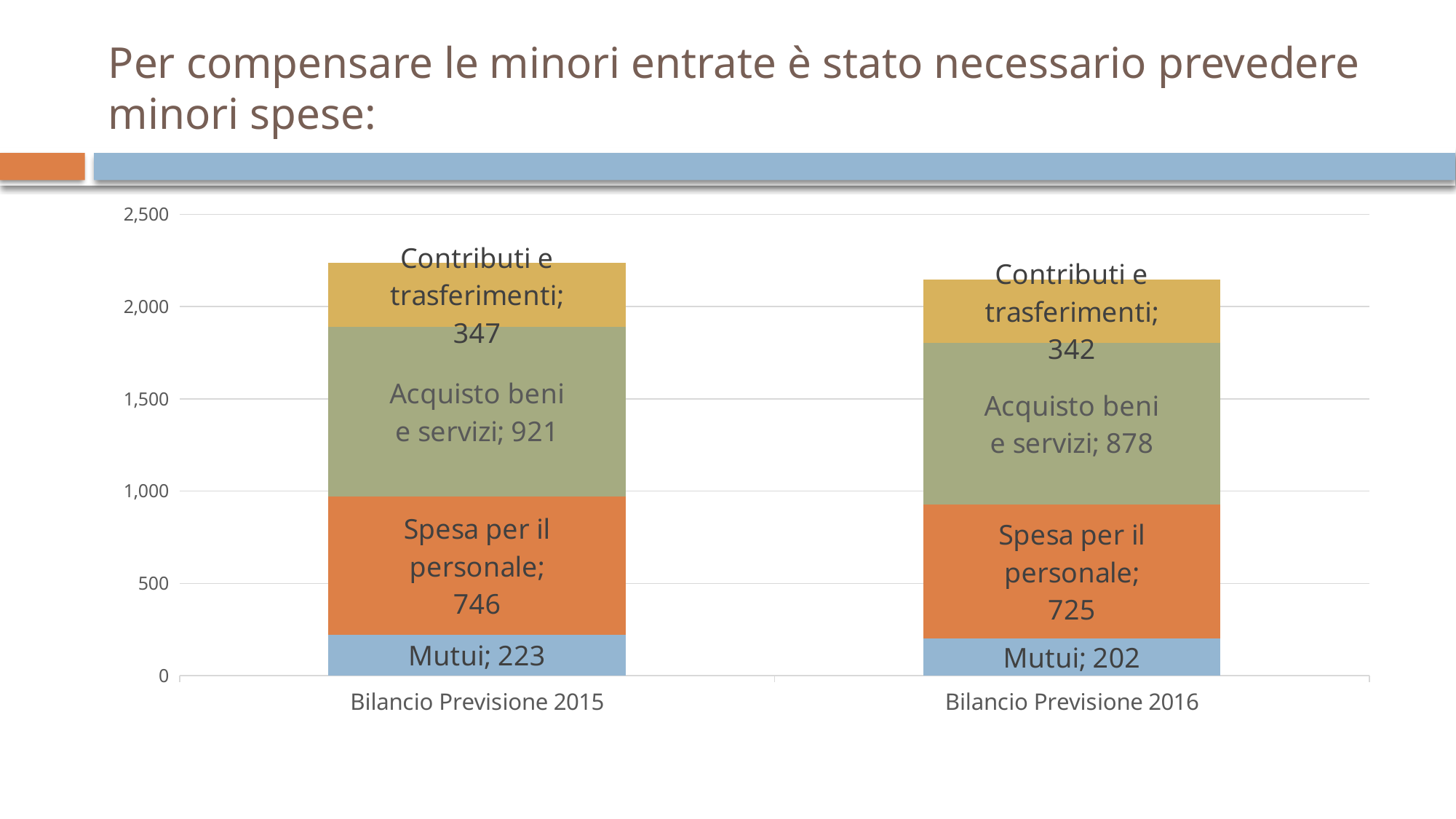
What kind of chart is shown on the slide? Stacked bar chart What is the total of the stacked bar for Bilancio Previsione 2016? 2,147 What is the value for Acquisto beni e servizi in Bilancio Previsione 2016? 878 What is the value for Mutui in Bilancio Previsione 2015? 223 What is the difference between Spesa per il personale in Bilancio Previsione 2015 and Bilancio Previsione 2016? 21 What is the total of the stacked bar for Bilancio Previsione 2015? 2,237 Which is larger: Mutui in Bilancio Previsione 2015 or Mutui in Bilancio Previsione 2016? Bilancio Previsione 2015 What is the value for Spesa per il personale in Bilancio Previsione 2016? 725 What is the value for Contributi e trasferimenti in Bilancio Previsione 2015? 347 What is the difference between Acquisto beni e servizi in Bilancio Previsione 2015 and Bilancio Previsione 2016? 43 Which segment is the largest in the Bilancio Previsione 2016 bar? Acquisto beni e servizi Which segment is the smallest in the Bilancio Previsione 2015 bar? Mutui